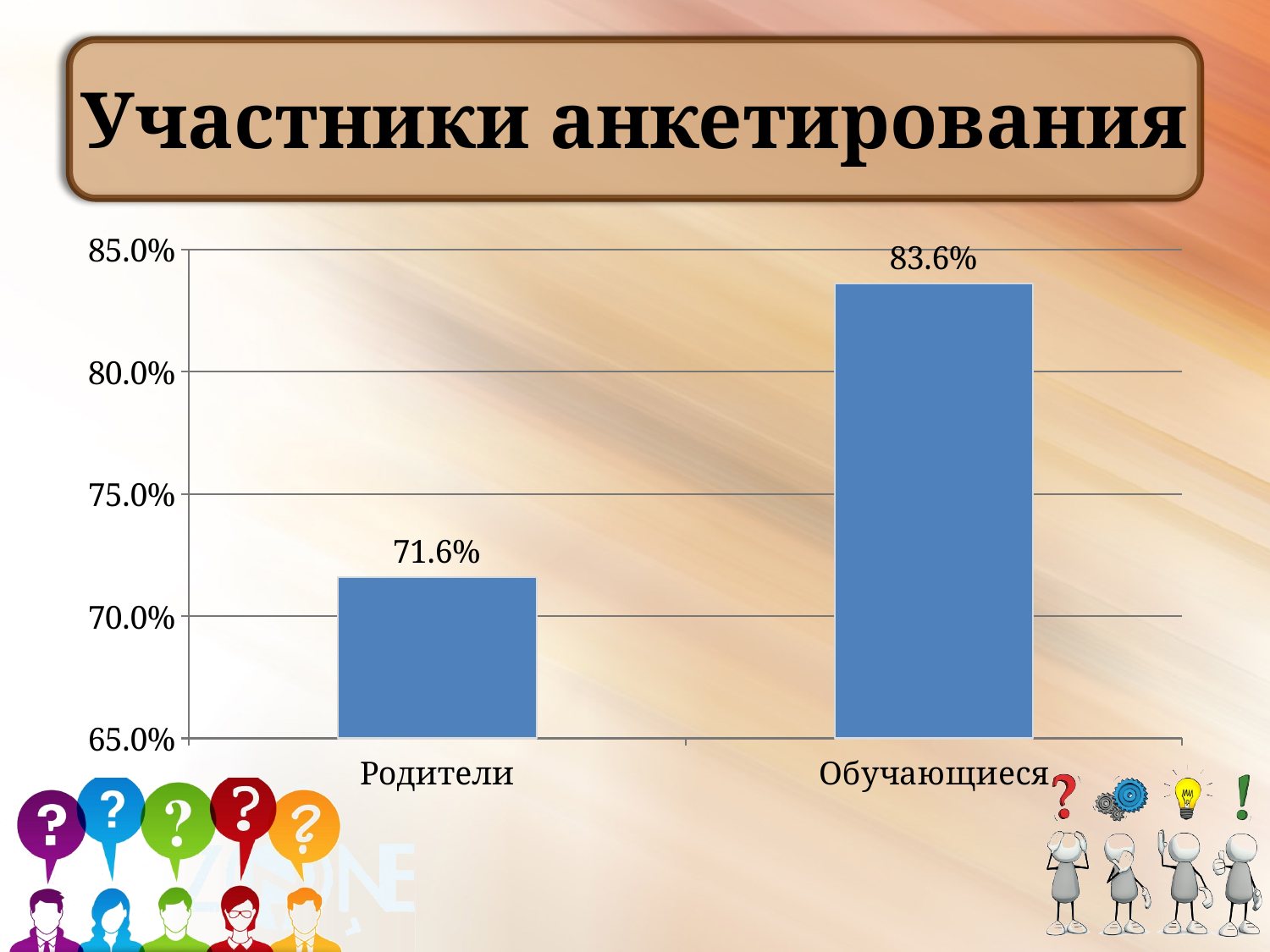
What is the value for Обучающиеся? 83.6% Which is larger, the value for Родители or the value for Обучающиеся? Обучающиеся Which category has the highest value? Обучающиеся What is the value for Родители? 71.6% How many categories are shown on the chart? 2 Is the value for Родители greater or less than 75.0%? less What is the title of the slide above the chart? Участники анкетирования Is the value for Обучающиеся greater or less than 80.0%? greater What kind of chart is shown on the slide? bar chart What is the highest value shown on the vertical axis? 85.0% Which category has the lowest value? Родители What is the difference between the values for Обучающиеся and Родители? 12.0%